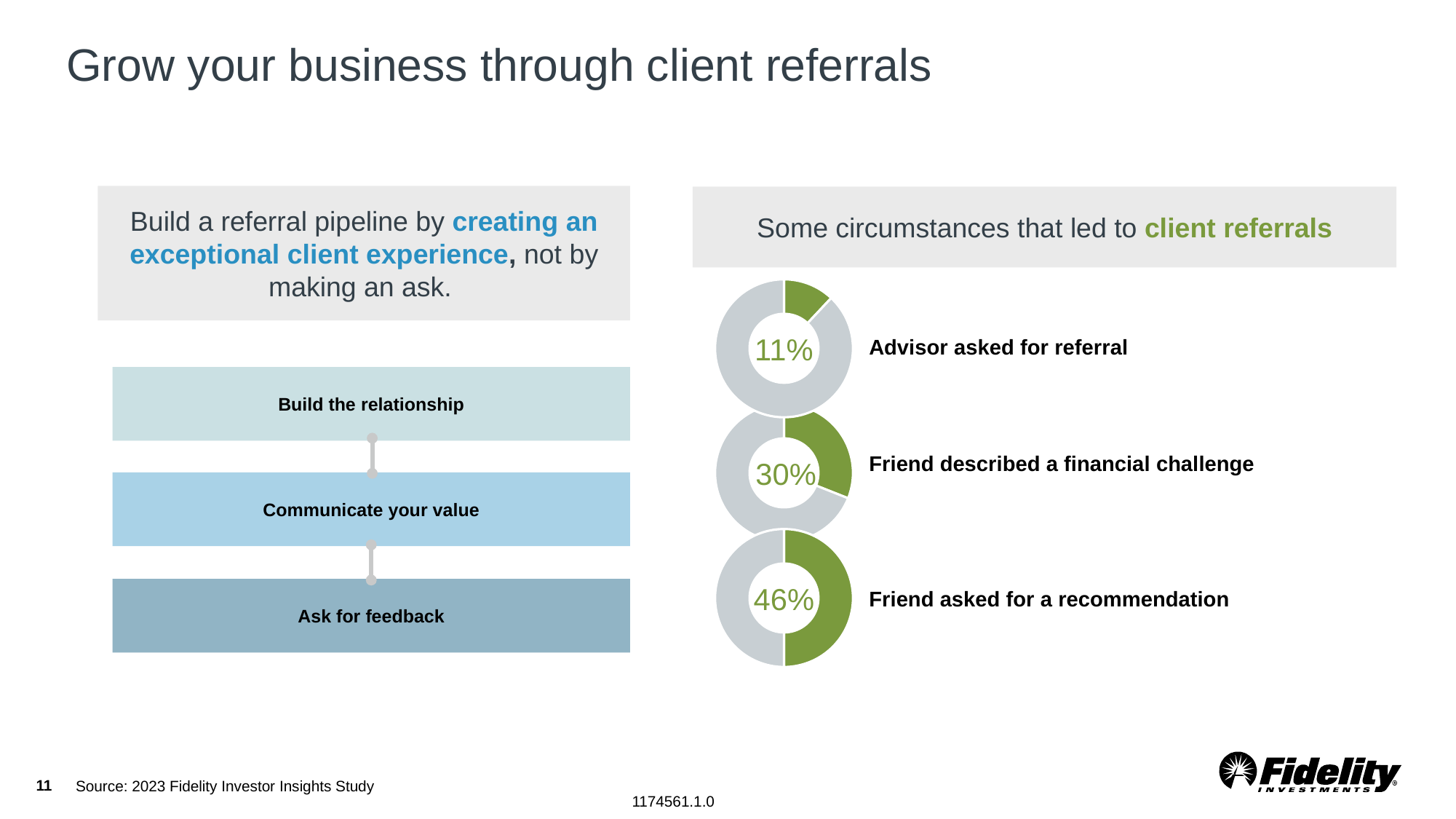
What kind of chart is used to show the circumstances that led to client referrals? Donut chart In the donut charts on the right, what percentage is shown for 'Friend described a financial challenge'? 30% In the donut charts on the right, what is the difference between the percentage for 'Friend asked for a recommendation' and 'Advisor asked for referral'? 35 percentage points Among the circumstances that led to client referrals shown in the donut charts, which has the lowest percentage? Advisor asked for referral Among the circumstances that led to client referrals shown in the donut charts, which has the highest percentage? Friend asked for a recommendation In the donut charts on the right, which is larger: the percentage for 'Friend described a financial challenge' or for 'Advisor asked for referral'? Friend described a financial challenge In the donut charts on the right, what percentage is shown for 'Friend asked for a recommendation'? 46% How many donut charts are shown under 'Some circumstances that led to client referrals'? 3 What is the heading above the donut charts on the right side of the slide? Some circumstances that led to client referrals In the donut charts on the right, what colour is the segment representing the stated percentage? Green In the donut charts under 'Some circumstances that led to client referrals', what percentage is shown for 'Advisor asked for referral'? 11% In the donut charts on the right, what is the difference between the percentage for 'Friend asked for a recommendation' and 'Friend described a financial challenge'? 16 percentage points